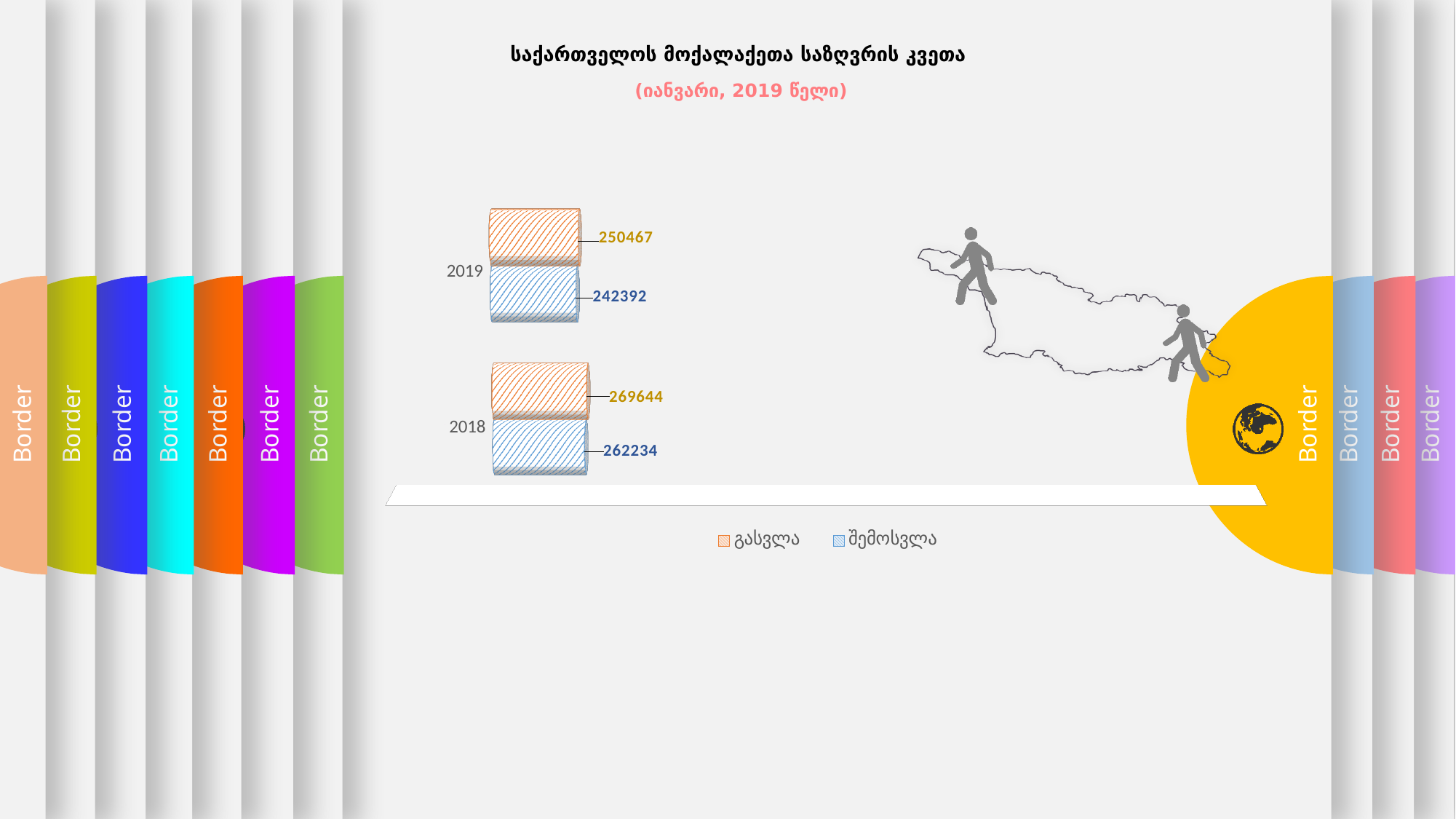
In 2018, which is larger: გასვლა or შემოსვლა? გასვლა What is the difference between გასვლა and შემოსვლა in 2019? 8075 What is the value of შემოსვლა for 2019? 242392 What is the value of შემოსვლა for 2018? 262234 How many years are shown on the chart? 2 What type of chart is shown on the slide? Bar chart What is the value of გასვლა for 2018? 269644 Which year has the higher value for გასვლა? 2018 What is the value of გასვლა for 2019? 250467 How many series does the legend list? 2 Which year has the lower value for შემოსვლა? 2019 What is the difference between გასვლა in 2018 and გასვლა in 2019? 19177